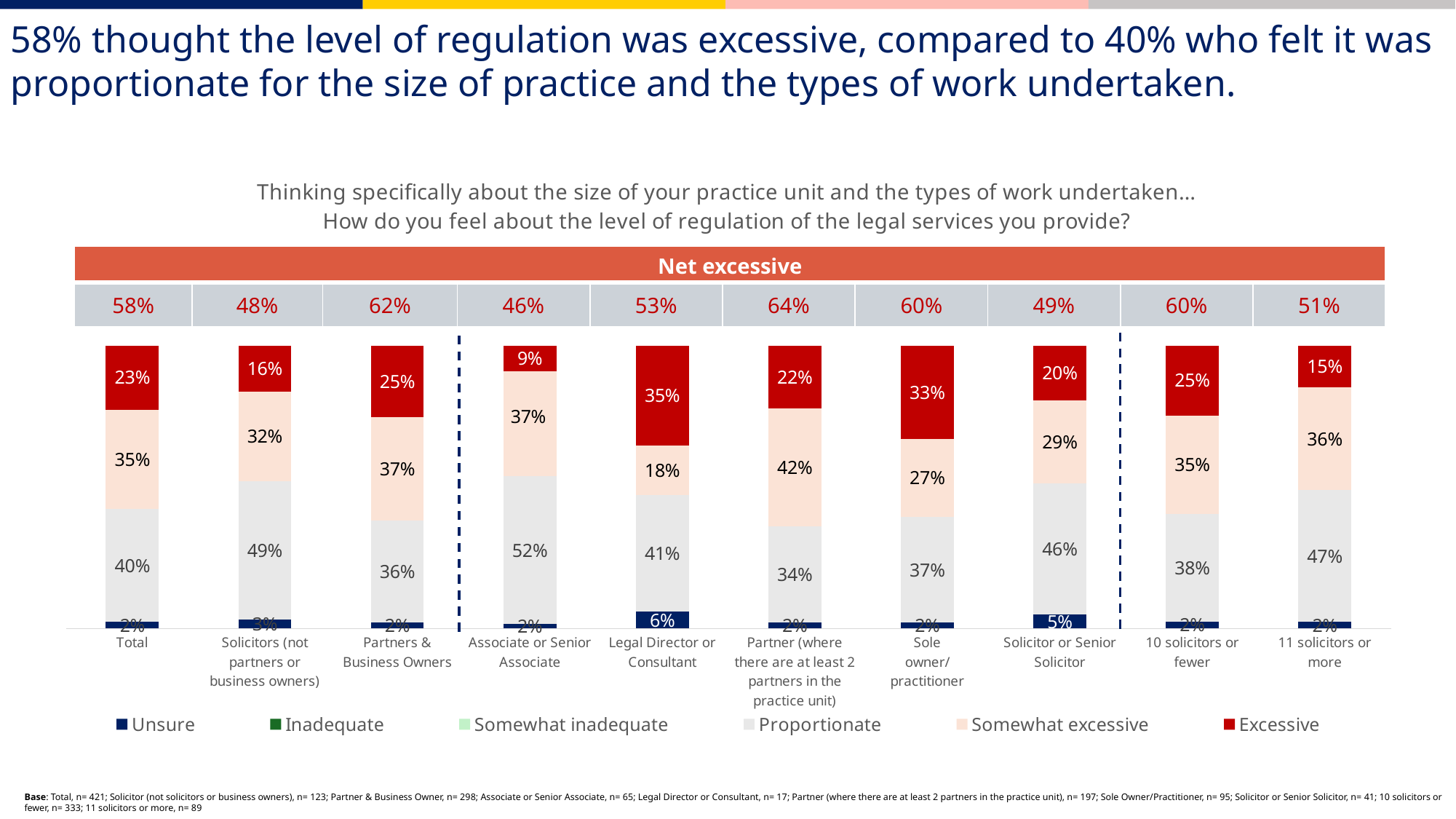
Which category has the highest Excessive percentage? Legal Director or Consultant What kind of chart is shown on the slide? Stacked bar chart What is the Proportionate value for Associate or Senior Associate? 52% What percentage of the Total group said the level of regulation was Excessive? 23% What is the difference between the Proportionate values for Associate or Senior Associate and Partner (where there are at least 2 partners in the practice unit)? 18% Which has a higher Net excessive figure: 10 solicitors or fewer, or 11 solicitors or more? 10 solicitors or fewer How many series does the legend list? 6 How many categories are shown along the x axis of the chart? 10 What is the Unsure value for Solicitor or Senior Solicitor? 5% What is the Somewhat excessive value for Legal Director or Consultant? 18% Which category has the lowest Excessive percentage? Associate or Senior Associate What is the Net excessive figure shown for Partners & Business Owners? 62%